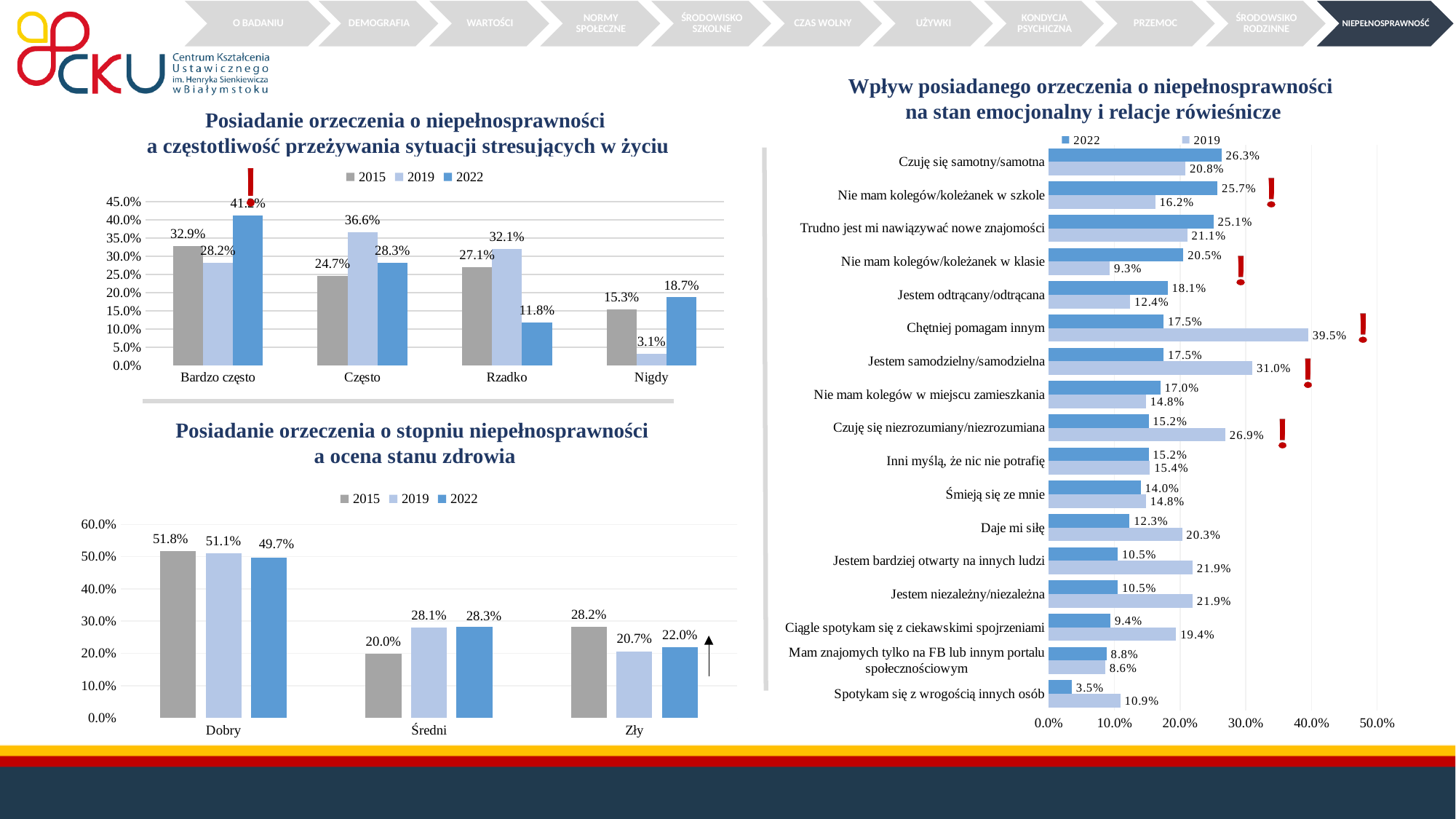
In the chart 'Posiadanie orzeczenia o niepełnosprawności a częstotliwość przeżywania sytuacji stresujących w życiu', what is the difference between the 2015 and 2022 values for 'Rzadko'? 15.3% In the chart 'Posiadanie orzeczenia o stopniu niepełnosprawności a ocena stanu zdrowia', is the 2015 value for 'Średni' larger or smaller than the 2015 value for 'Zły'? smaller How many categories are shown on the x axis of the chart 'Posiadanie orzeczenia o stopniu niepełnosprawności a ocena stanu zdrowia'? 3 How many series does the legend list in the chart 'Posiadanie orzeczenia o niepełnosprawności a częstotliwość przeżywania sytuacji stresujących w życiu'? 3 In the chart 'Wpływ posiadanego orzeczenia o niepełnosprawności na stan emocjonalny i relacje rówieśnicze', which category has the lowest 2022 value? Spotykam się z wrogością innych osób In the chart 'Posiadanie orzeczenia o stopniu niepełnosprawności a ocena stanu zdrowia', which category has the highest value for 2015? Dobry In the chart 'Posiadanie orzeczenia o stopniu niepełnosprawności a ocena stanu zdrowia', what is the value for 'Zły' in 2022? 22.0% In the chart 'Wpływ posiadanego orzeczenia o niepełnosprawności na stan emocjonalny i relacje rówieśnicze', what is the difference between the 2022 and 2019 values for 'Nie mam kolegów/koleżanek w klasie'? 11.2% In the chart 'Posiadanie orzeczenia o niepełnosprawności a częstotliwość przeżywania sytuacji stresujących w życiu', what is the value for 'Często' in 2019? 36.6% In the chart 'Posiadanie orzeczenia o niepełnosprawności a częstotliwość przeżywania sytuacji stresujących w życiu', which category has the lowest value for 2019? Nigdy In the chart 'Wpływ posiadanego orzeczenia o niepełnosprawności na stan emocjonalny i relacje rówieśnicze', what is the 2019 value for 'Chętniej pomagam innym'? 39.5% What kind of chart is 'Wpływ posiadanego orzeczenia o niepełnosprawności na stan emocjonalny i relacje rówieśnicze'? bar chart